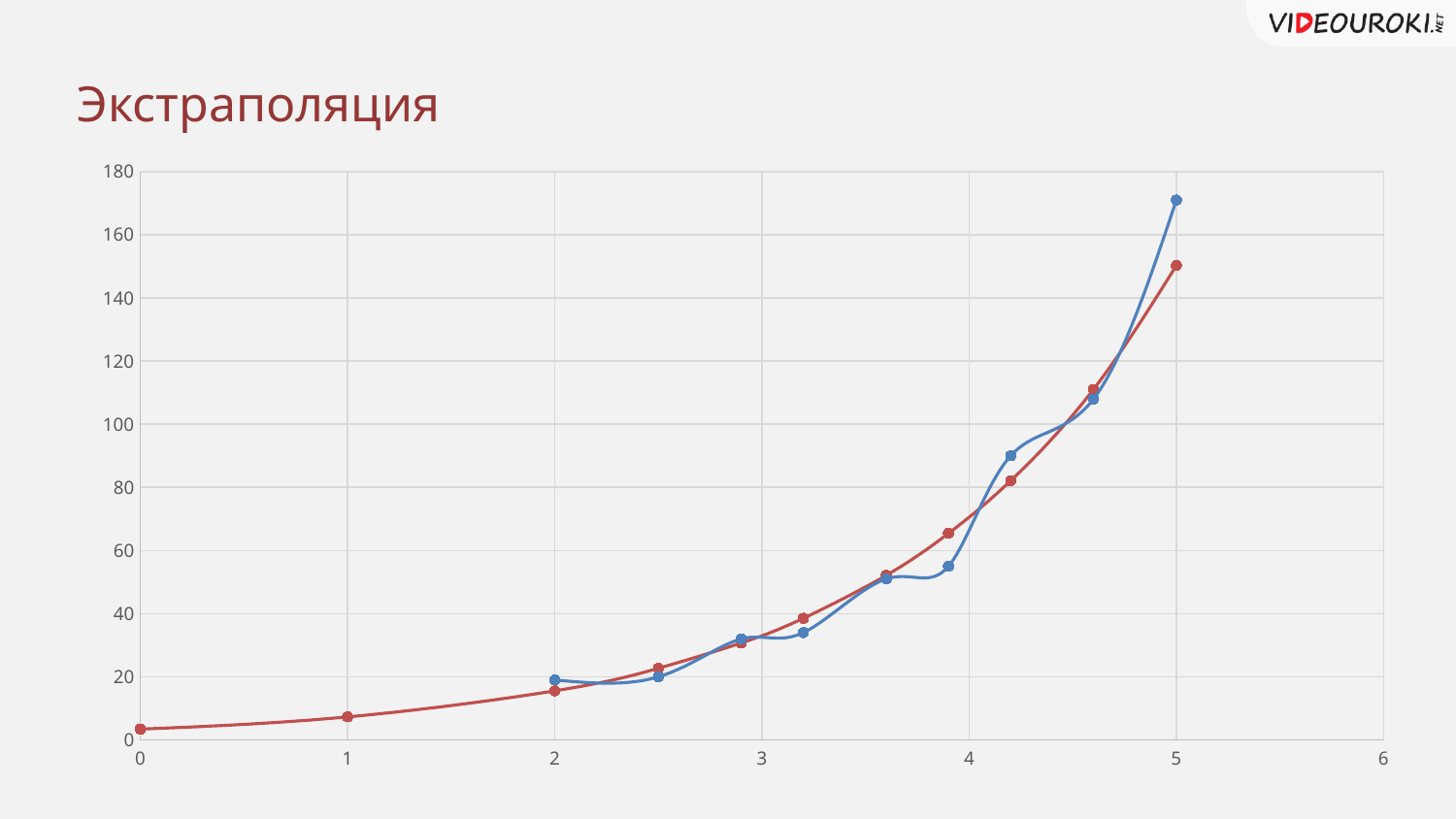
What kind of chart is shown on the slide? line chart Is the value of the red line at x = 5 greater or less than 160? less What colours are the two lines on the chart? blue and red At x = 3.9, which line has the higher value, blue or red? red How many lines (series) are plotted on the chart? 2 At x = 5, which line has the higher value, blue or red? blue What is the title of the chart on the slide? Экстраполяция Is the value of the blue line at x = 5 greater or less than 160? greater Is the value of the red line at x = 1 greater or less than 20? less Do the values of the lines rise or fall as x increases from 0 to 5? rise Which line reaches the highest point on the chart? blue